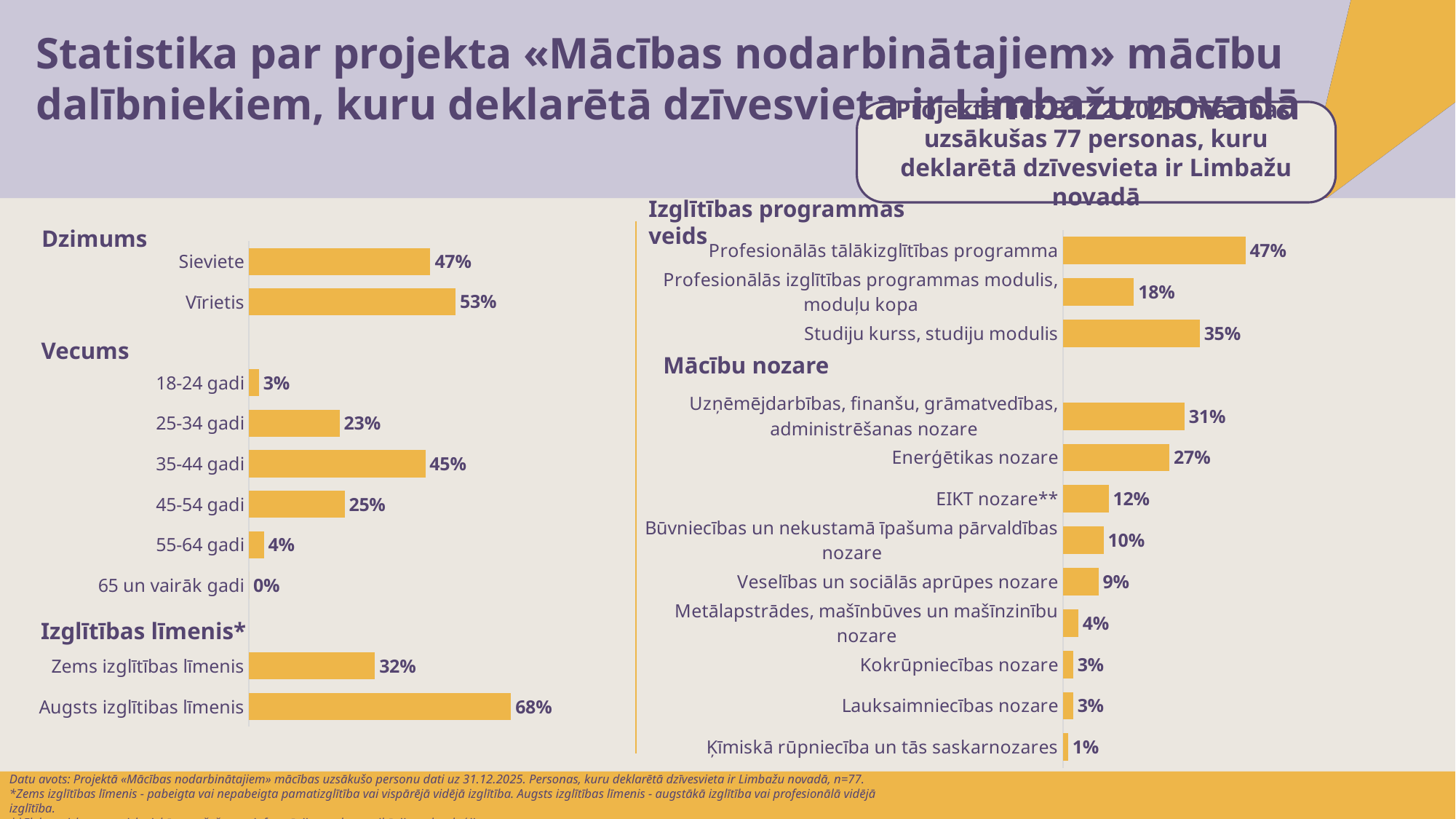
In the Mācību nozare chart, what is the value for EIKT nozare**? 12% In the Vecums chart, which age group has the highest value? 35-44 gadi In the Mācību nozare chart, how many sectors are listed? 9 In the Izglītības programmas veids chart, which category has the lowest value? Profesionālās izglītības programmas modulis, moduļu kopa In the Dzimums chart, what is the value for Vīrietis? 53% In the Mācību nozare chart, which is larger: Enerģētikas nozare or Veselības un sociālās aprūpes nozare? Enerģētikas nozare In the Izglītības programmas veids chart, what is the value for Studiju kurss, studiju modulis? 35% What type of chart is used for the Vecums data? Bar chart In the Vecums chart, what is the value for 25-34 gadi? 23% In the Vecums chart, how many age categories are shown? 6 In the Izglītības līmenis chart, what is the difference between Augsts izglītības līmenis and Zems izglītības līmenis? 36 percentage points In the Mācību nozare chart, which sector has the highest value? Uzņēmējdarbības, finanšu, grāmatvedības, administrēšanas nozare